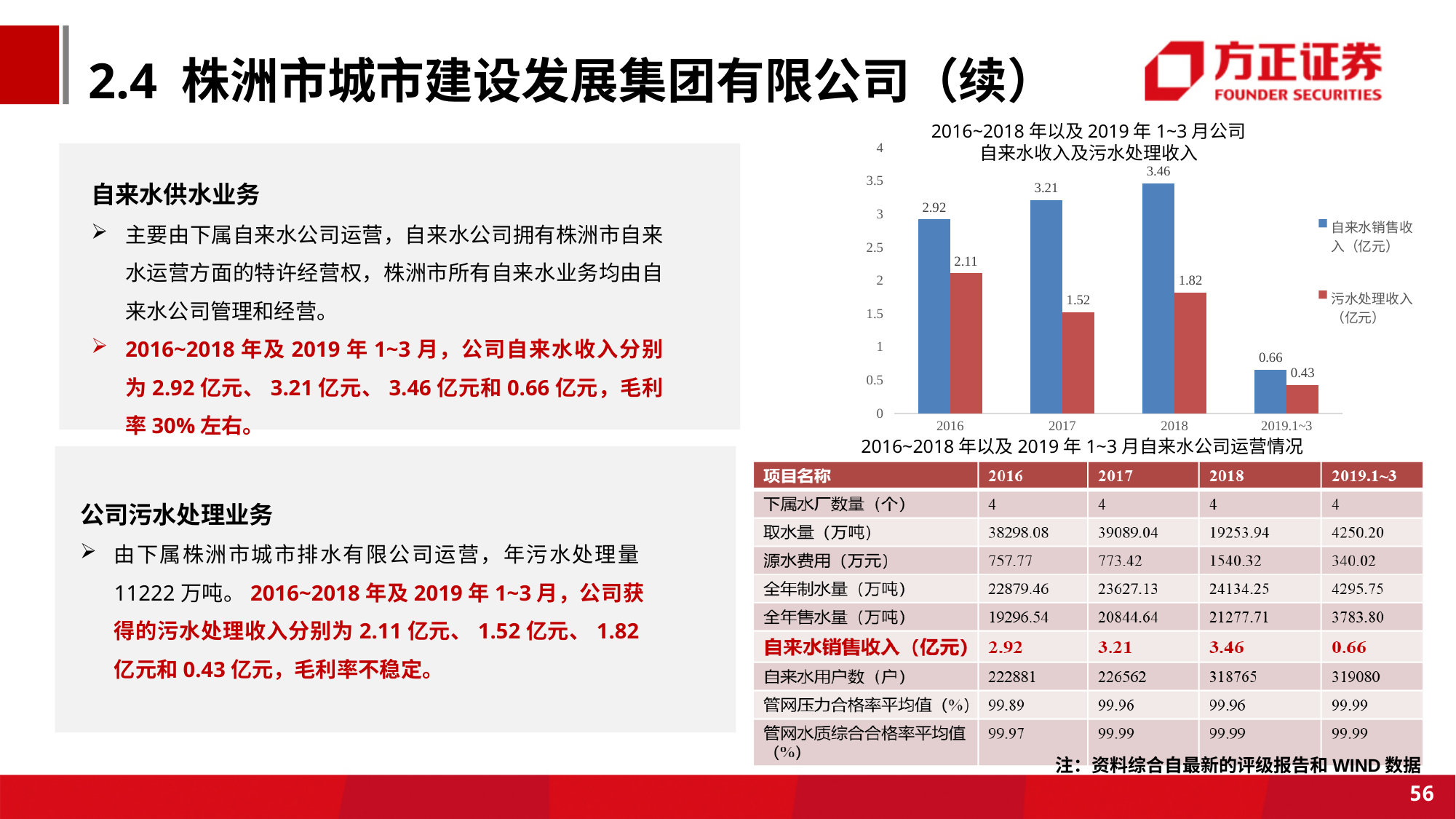
Does 自来水销售收入 (亿元) rise or fall from 2016 to 2018? rise What is the value of 污水处理收入 (亿元) for 2019.1~3? 0.43 What is the difference between 自来水销售收入 and 污水处理收入 in 2016? 0.81 In which period is 污水处理收入 (亿元) the lowest? 2019.1~3 How many categories are shown on the x axis of the chart? 4 What type of chart is shown on the slide? bar chart In which year is 自来水销售收入 (亿元) the highest? 2018 What is the title of the chart? 2016~2018 年以及 2019 年 1~3 月公司自来水收入及污水处理收入 How many series does the chart legend list? 2 What is the value of 自来水销售收入 (亿元) for 2017? 3.21 Which is larger in 2017: 自来水销售收入 or 污水处理收入? 自来水销售收入 What is the value of 污水处理收入 (亿元) for 2018? 1.82